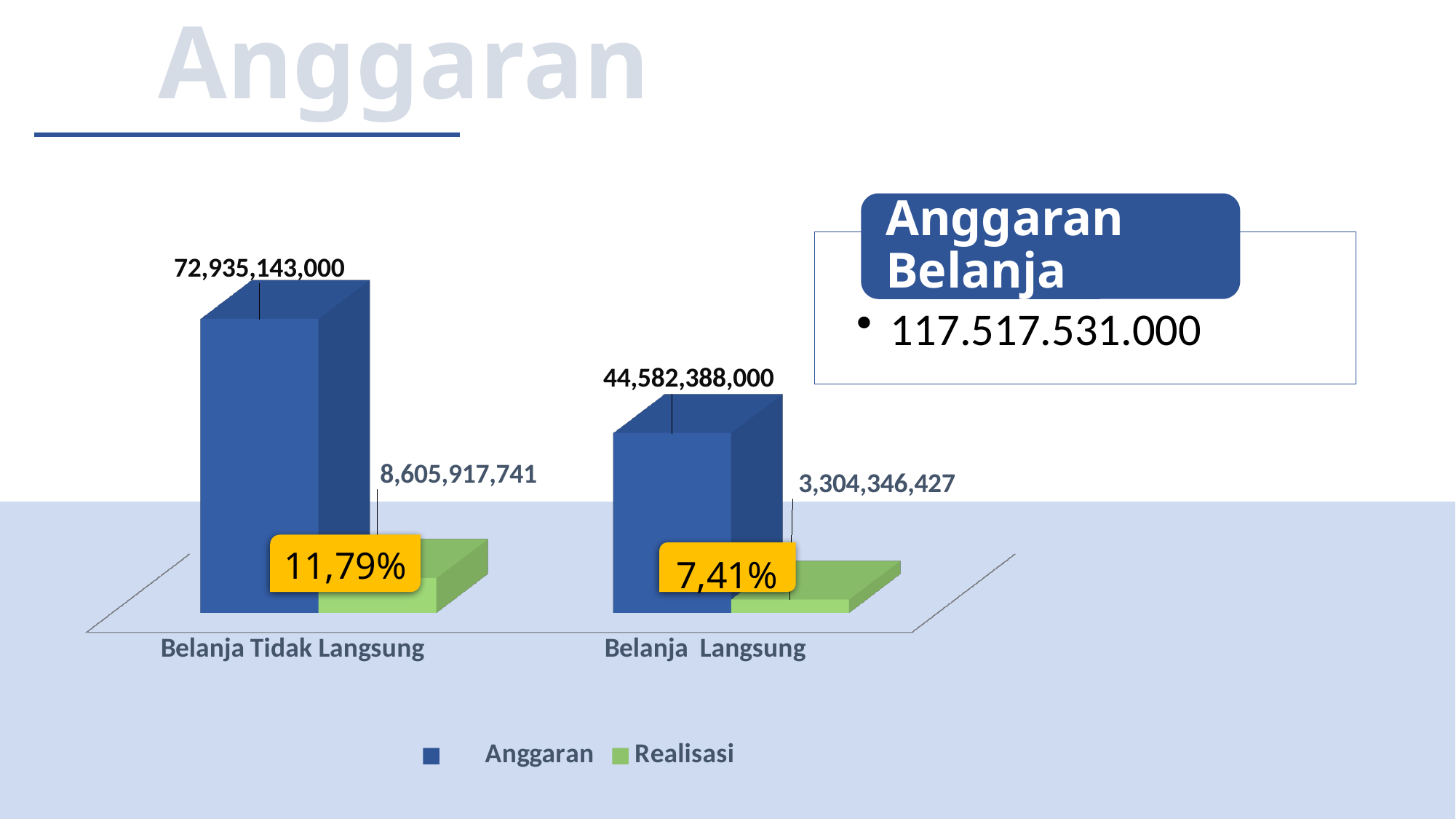
What is the Anggaran value for Belanja Tidak Langsung? 72,935,143,000 What is the Realisasi value for Belanja Tidak Langsung? 8,605,917,741 What kind of chart is shown on the slide? bar chart What is the difference between the Anggaran values for Belanja Tidak Langsung and Belanja Langsung? 28,352,755,000 What percentage label is shown for Belanja Tidak Langsung? 11,79% Is the Realisasi value for Belanja Tidak Langsung larger or smaller than the Anggaran value for Belanja Langsung? smaller Which category has the lower Realisasi value? Belanja Langsung What is the Realisasi value for Belanja Langsung? 3,304,346,427 What is the Anggaran value for Belanja Langsung? 44,582,388,000 Which category has the higher Anggaran value? Belanja Tidak Langsung What percentage label is shown for Belanja Langsung? 7,41% How many series does the legend list? 2